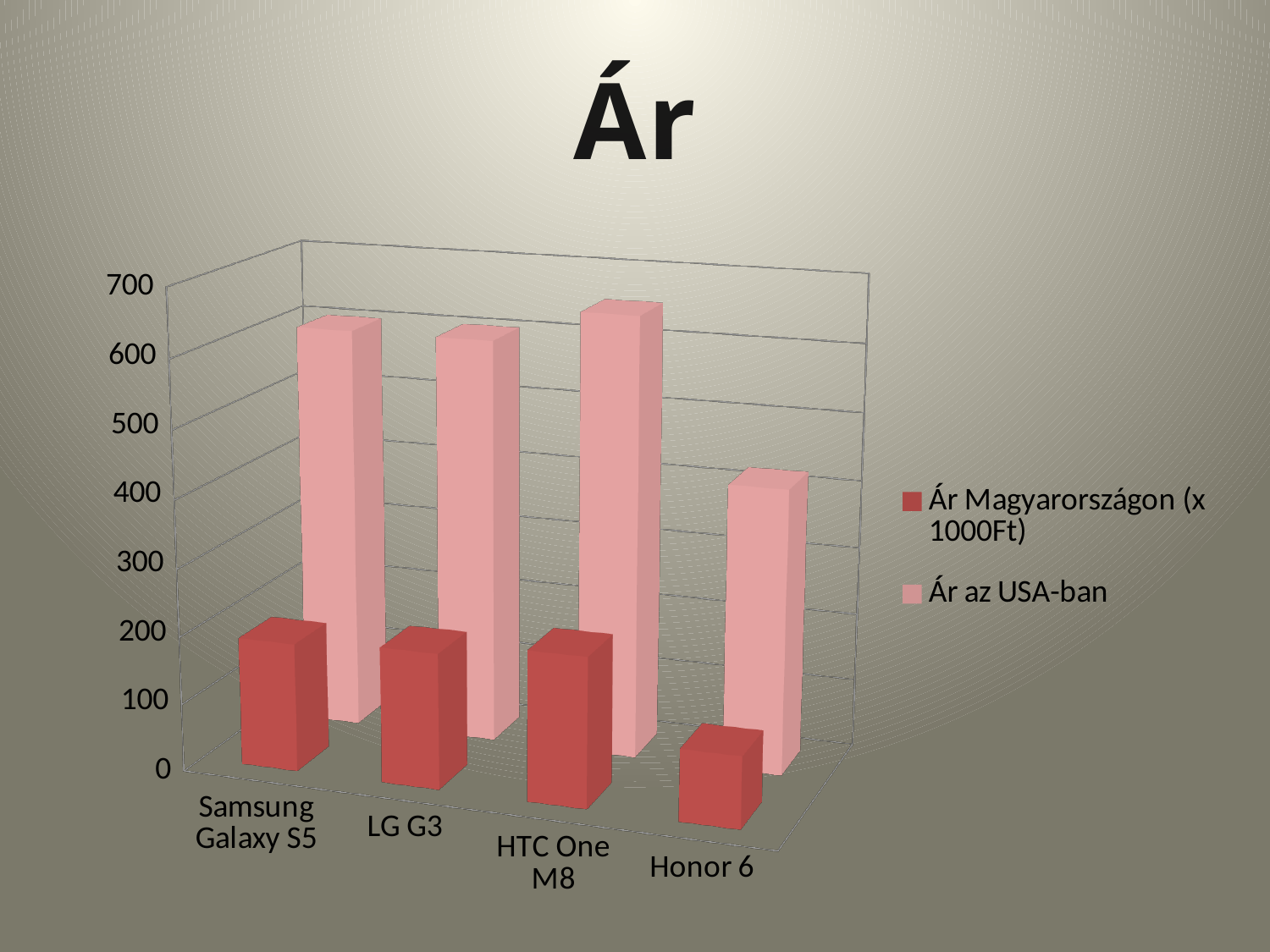
For Honor 6, which series has the larger value: 'Ár Magyarországon (x 1000Ft)' or 'Ár az USA-ban'? Ár az USA-ban Which phone has the lowest value in the 'Ár az USA-ban' series? Honor 6 How many series does the legend list? 2 How many phone models are shown on the x axis? 4 For Samsung Galaxy S5, which series has the larger value: 'Ár Magyarországon (x 1000Ft)' or 'Ár az USA-ban'? Ár az USA-ban Is the 'Ár az USA-ban' value for Honor 6 greater or less than 500? less What is the title of the chart? Ár Which phone has the lowest value in the 'Ár Magyarországon (x 1000Ft)' series? Honor 6 Is the 'Ár Magyarországon (x 1000Ft)' value for LG G3 greater or less than 300? less Which series is drawn in the lighter pink colour? Ár az USA-ban What kind of chart is shown on the slide? bar chart Is the 'Ár az USA-ban' value for Samsung Galaxy S5 greater or less than 500? greater